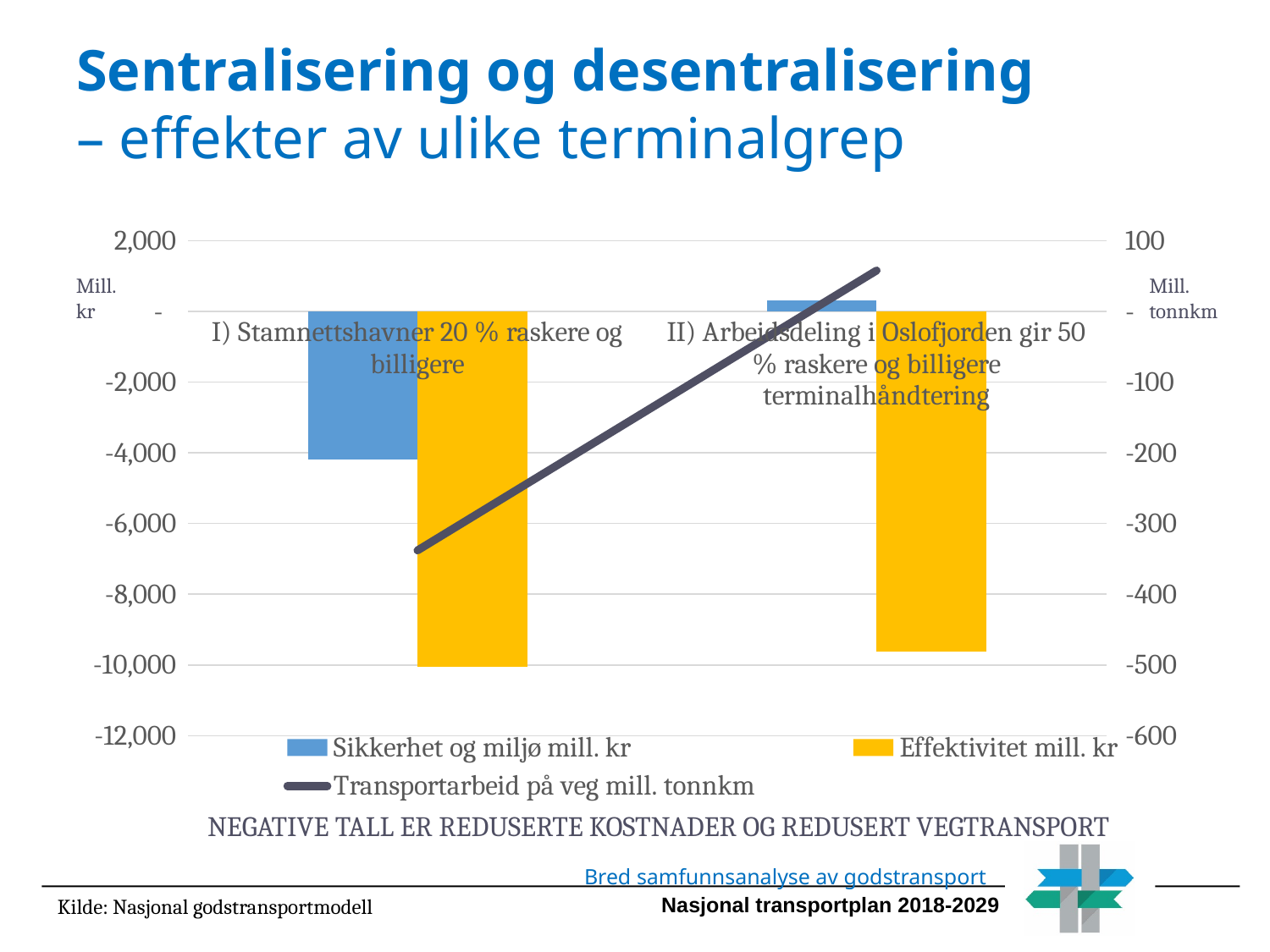
How many categories are shown on the x axis of the chart? 2 Which category has the lower value for Sikkerhet og miljø mill. kr? I) Stamnettshavner 20 % raskere og billigere Is the value of Sikkerhet og miljø mill. kr for category I (Stamnettshavner 20 % raskere og billigere) greater or less than -2,000? less Is the value of Sikkerhet og miljø mill. kr for category II (Arbeidsdeling i Oslofjorden) greater or less than 0? greater What unit is shown on the right-hand axis of the chart? Mill. tonnkm What kind of chart is shown on the slide? Bar chart with a line series Is the value of Effektivitet mill. kr for category II (Arbeidsdeling i Oslofjorden) greater or less than -8,000? less Does the Transportarbeid på veg mill. tonnkm line rise or fall from category I to category II? rises Which series is plotted in yellow? Effektivitet mill. kr How many series does the chart legend list? 3